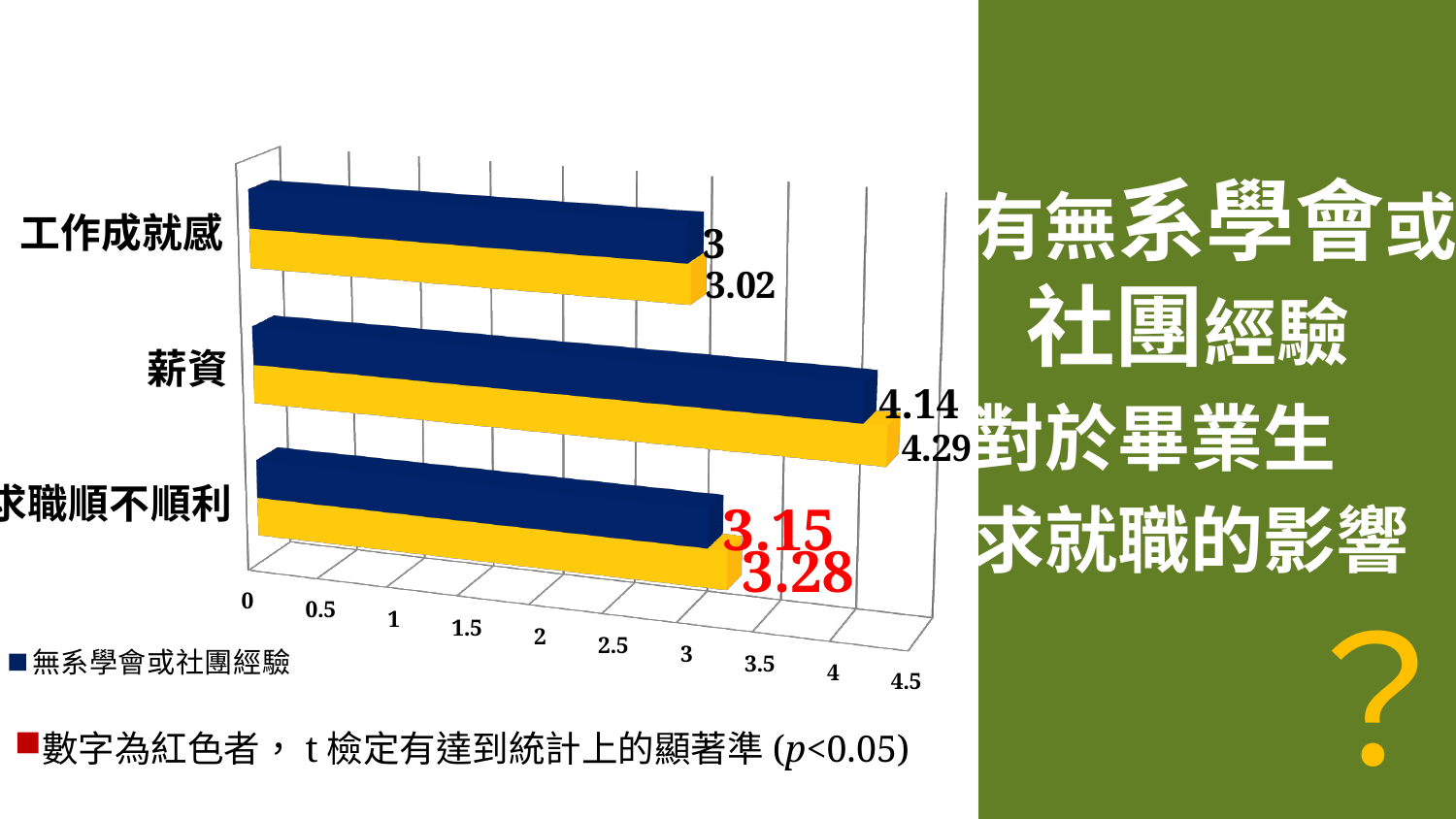
What is the difference between the yellow and blue bars for 薪資? 0.15 What is the value of the yellow bar for 薪資? 4.29 What is the value of the yellow bar for 求職順不順利? 3.28 What is the value of the yellow bar for 工作成就感? 3.02 What is the value of the blue bar (無系學會或社團經驗) for 工作成就感? 3 Which data labels on the chart are printed in red? 3.15 and 3.28 Which category has the highest value for the blue series (無系學會或社團經驗)? 薪資 What is the value of the blue bar (無系學會或社團經驗) for 薪資? 4.14 How many categories are shown on the chart's vertical axis? 3 For 求職順不順利, which bar is larger, the blue one or the yellow one? the yellow one What kind of chart is shown on the slide? bar chart What is the value of the blue bar (無系學會或社團經驗) for 求職順不順利? 3.15